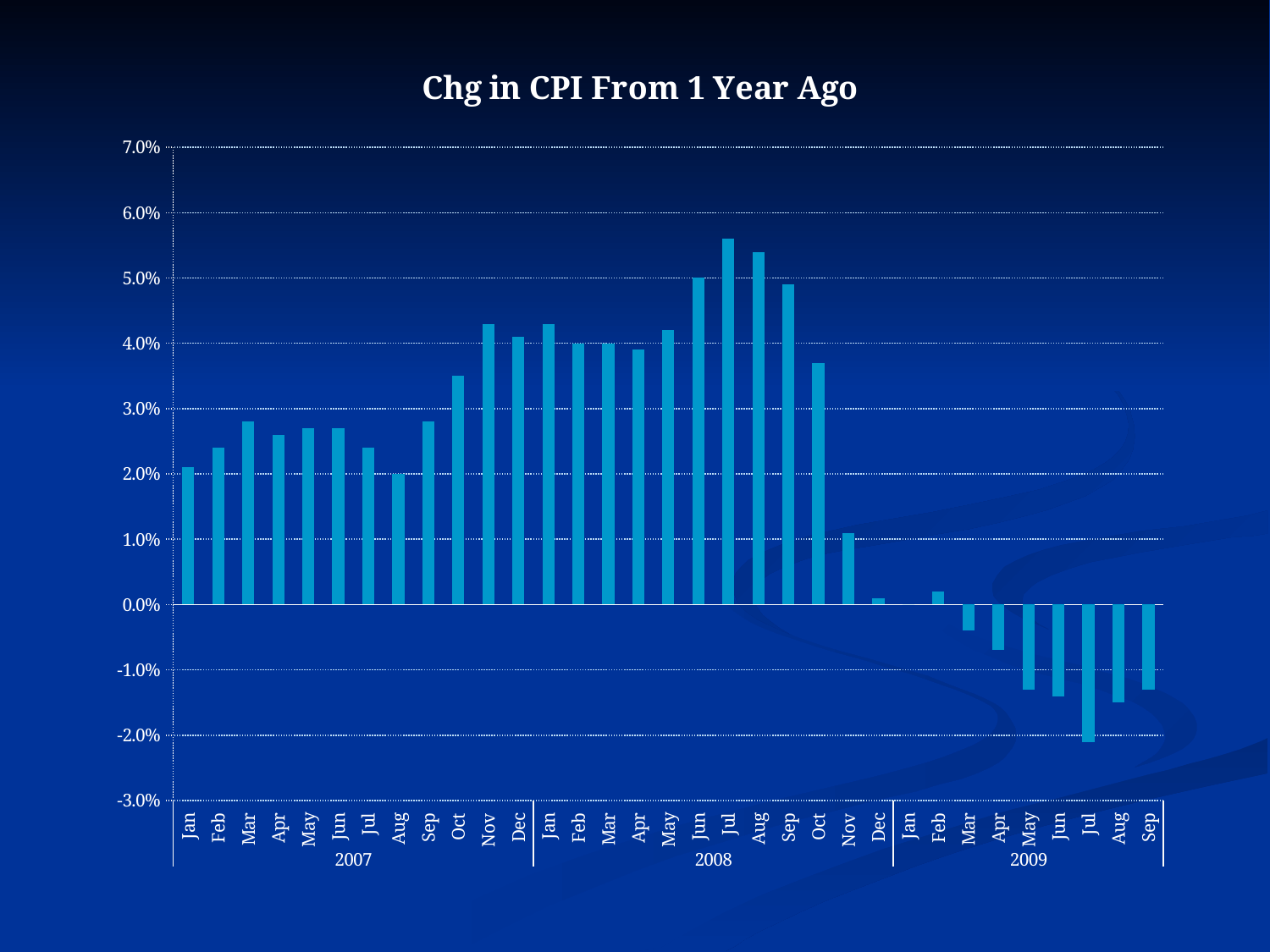
Is the value for Dec 2008 greater or less than 1.0%? less Which month has the lowest change in CPI from 1 year ago? Jul 2009 Which is larger, the value for Mar 2009 or the value for Apr 2009? Mar 2009 Is the value for Oct 2007 greater or less than 3.0%? greater Do the values rise or fall from Jan 2009 to Jul 2009? fall Is the value for Jul 2008 greater or less than 5.0%? greater Which is larger, the value for Oct 2008 or the value for Nov 2008? Oct 2008 What kind of chart is shown on the slide? Bar chart What is the title of the chart? Chg in CPI From 1 Year Ago How many monthly bars are plotted in the chart? 33 Which month has the highest change in CPI from 1 year ago? Jul 2008